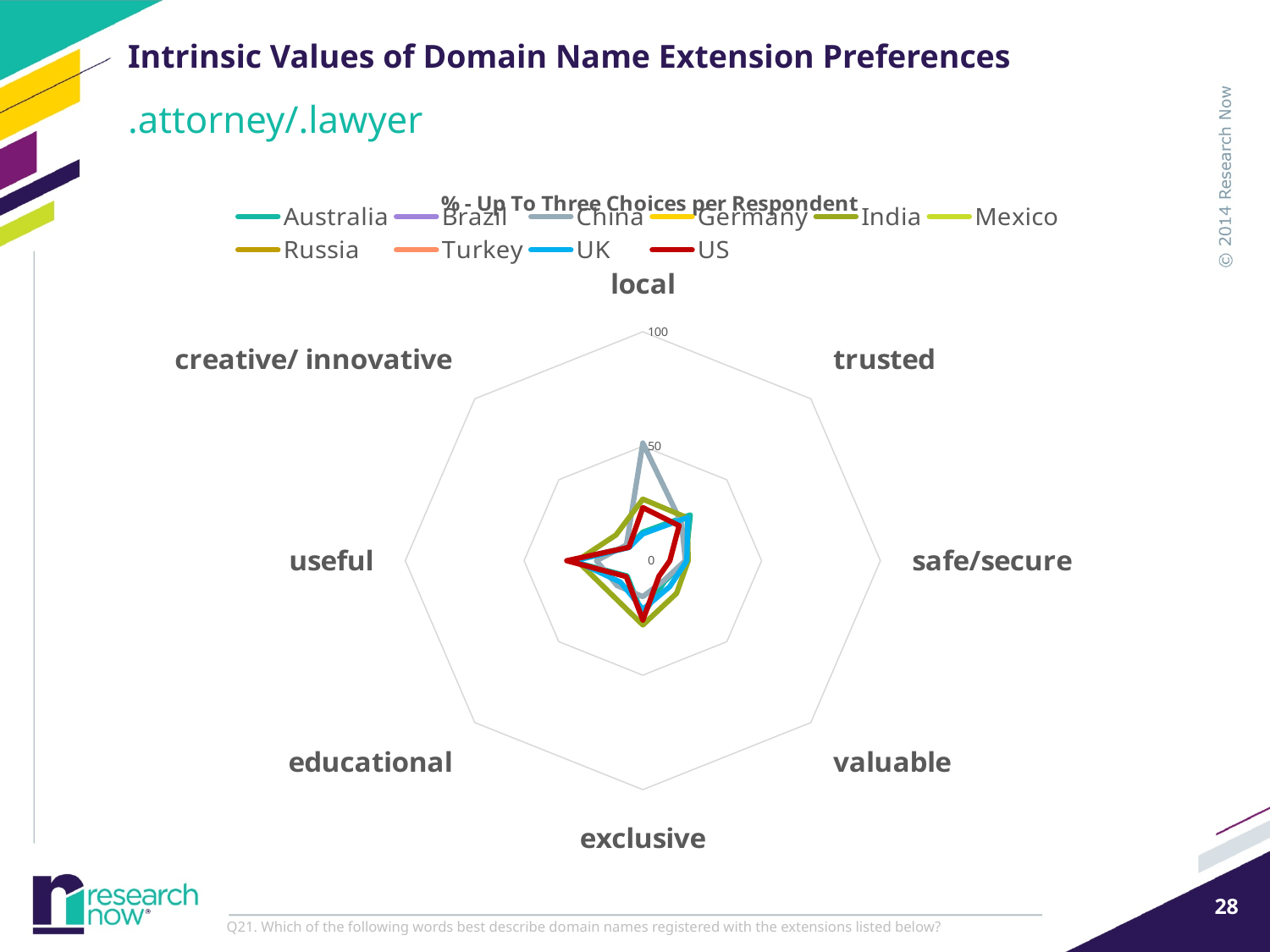
How many series does the legend list? 10 Which domain name extension does the chart on this slide refer to? .attorney/.lawyer Which series reaches the highest value on the local axis? China What is the title of the chart? % - Up To Three Choices per Respondent How many categories (axes) does the radar chart have? 8 Is the value for US on the exclusive axis greater or less than 50? less Is the value for China on the local axis greater or less than 100? less For the China series, which is larger: the value for local or the value for exclusive? local What kind of chart is shown on the slide? radar chart On which category does the China series reach its highest value? local What is the highest value shown on the radar chart's axis scale? 100